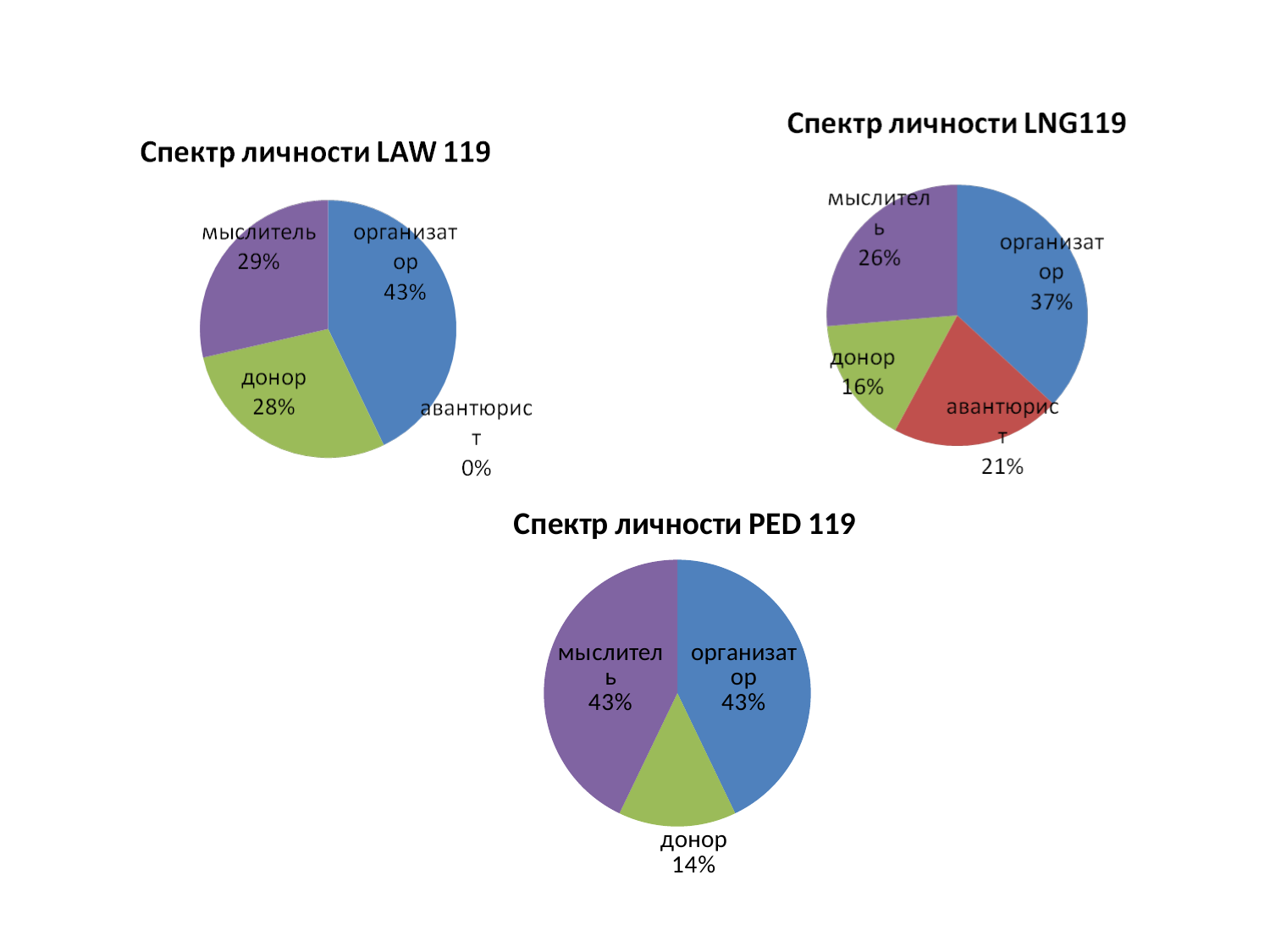
In the chart titled "Спектр личности LAW 119", which category has the smallest share? авантюрист In the chart titled "Спектр личности LAW 119", what share does "донор" have? 28% In the chart titled "Спектр личности LNG119", which is larger: the share of "мыслитель" or the share of "авантюрист"? мыслитель In the chart titled "Спектр личности LAW 119", what share does "организатор" have? 43% In the chart titled "Спектр личности LAW 119", which category has the largest share? организатор In the chart titled "Спектр личности LNG119", what is the difference between the shares of "организатор" and "мыслитель"? 11% In the chart titled "Спектр личности LNG119", which category has the smallest share? донор What type of chart is "Спектр личности PED 119"? Pie chart In the chart titled "Спектр личности PED 119", what share does "донор" have? 14% In the chart titled "Спектр личности LNG119", what share does "авантюрист" have? 21% In the chart titled "Спектр личности PED 119", how many categories are shown? 3 How many charts are on the slide? 3